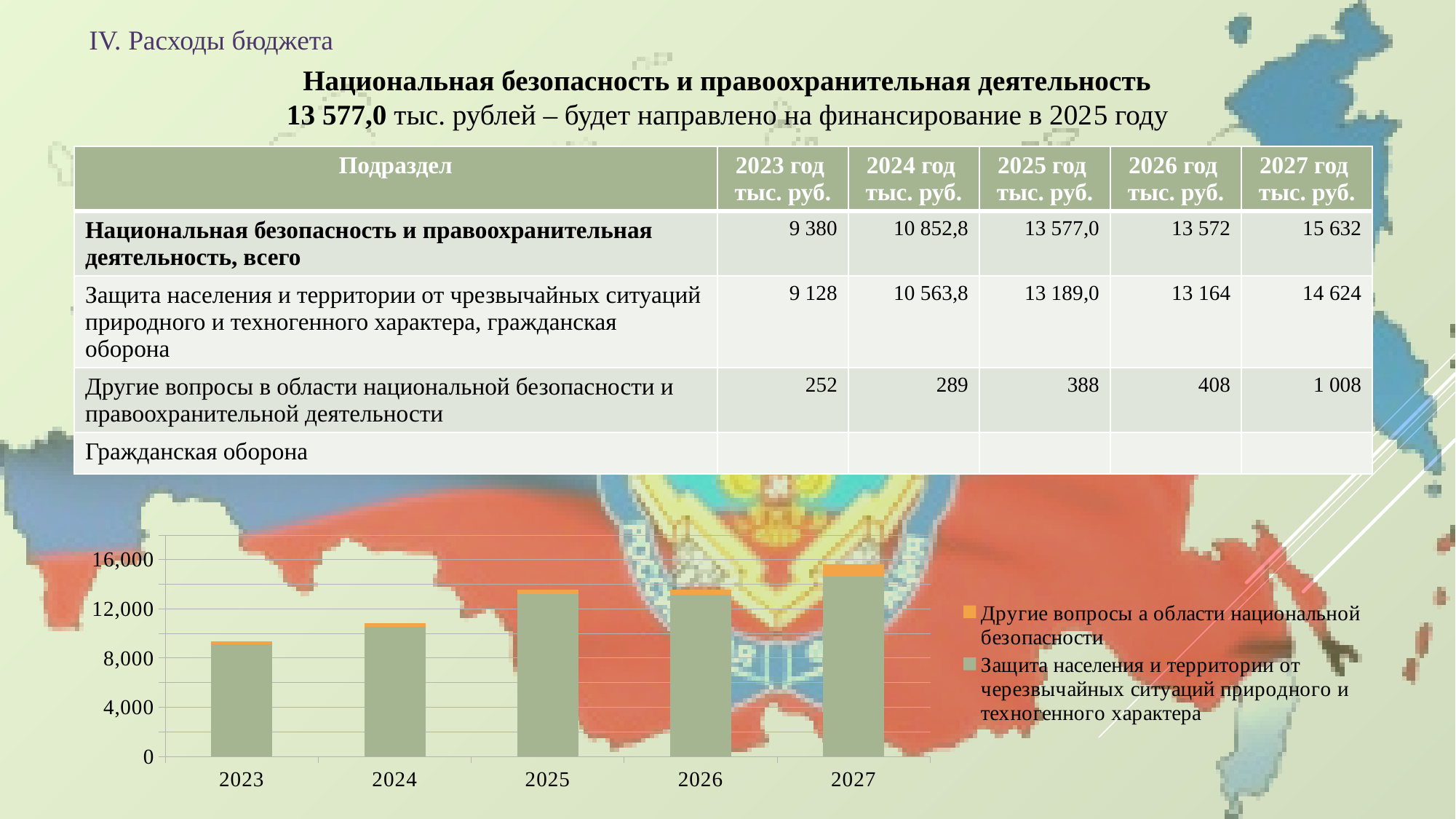
Is the total bar for 2024 greater or less than 12,000? less How many years are shown on the x axis of the bar chart? 5 How many series does the legend of the bar chart list? 2 Which bar is taller, 2024 or 2025? 2025 What kind of chart is shown at the bottom of the slide? Stacked bar chart Is the total bar for 2023 greater or less than 8,000? greater Is the total bar for 2025 greater or less than 12,000? greater Which year has the tallest bar in the chart? 2027 Which year has the shortest bar in the chart? 2023 Do the bar heights overall rise or fall from 2023 to 2027? rise Which colour represents the series 'Другие вопросы а области национальной безопасности' in the legend? Orange